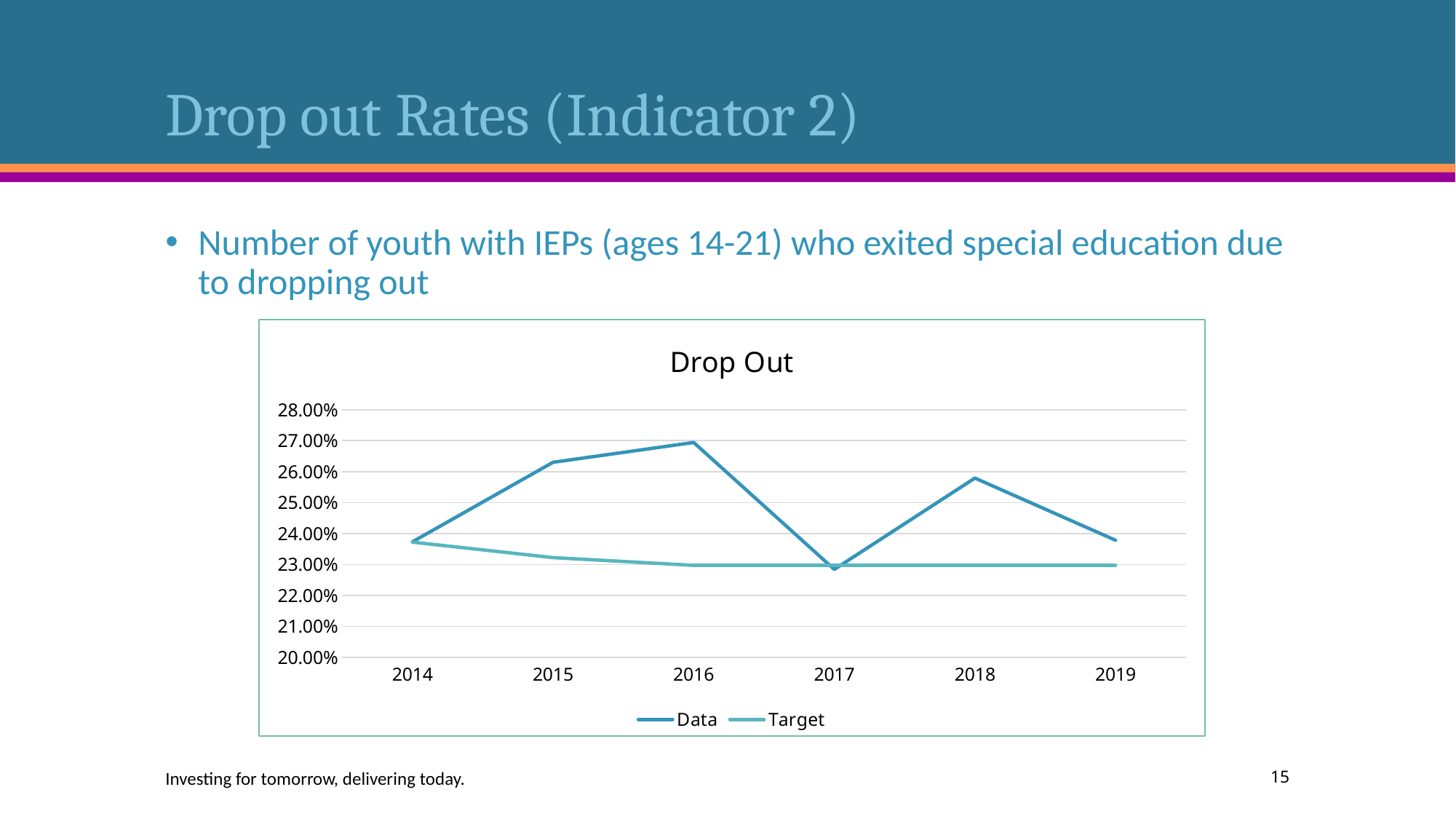
How many years are plotted along the x axis of the Drop Out chart? 6 Is the Target value for 2015 greater or less than 24.00%? less Does the Data series rise or fall from 2016 to 2017? fall Is the Data value for 2018 greater or less than 25.00%? greater In which year is the Data series highest in the Drop Out chart? 2016 Which year has the larger Data value, 2015 or 2019? 2015 Is the Data value for 2015 greater or less than 26.00%? greater In which year is the Data series lowest in the Drop Out chart? 2017 What kind of chart is shown on the slide? line chart Which is larger in 2018, the Data value or the Target value? Data What is the title of the chart? Drop Out How many series does the legend of the Drop Out chart list? 2